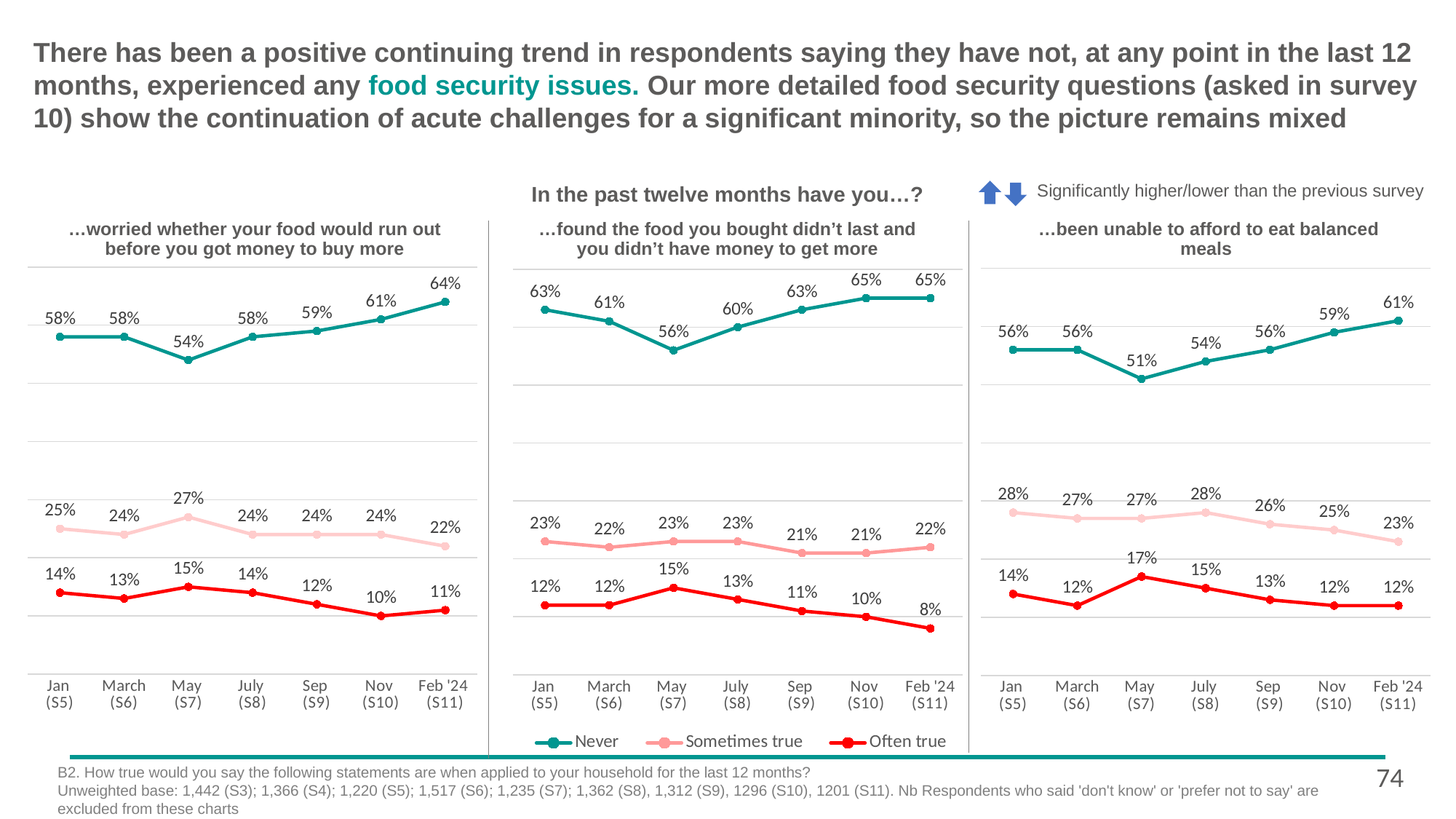
In the '…worried whether your food would run out before you got money to buy more' chart, at which survey is the 'Often true' value highest? May (S7) What kind of chart is used on this slide? Line chart In the '…been unable to afford to eat balanced meals' chart, which is larger: the 'Often true' value for May (S7) or for Feb '24 (S11)? May (S7) In the '…found the food you bought didn't last and you didn't have money to get more' chart, what is the 'Often true' value for Feb '24 (S11)? 8% In the '…worried whether your food would run out before you got money to buy more' chart, does the 'Never' series rise or fall from May (S7) to Feb '24 (S11)? Rise In the '…worried whether your food would run out before you got money to buy more' chart, what is the 'Never' value for Feb '24 (S11)? 64% In the '…found the food you bought didn't last and you didn't have money to get more' chart, what is the difference between the 'Never' values for May (S7) and Feb '24 (S11)? 9 percentage points In the '…been unable to afford to eat balanced meals' chart, at which survey is the 'Never' value lowest? May (S7) Which series is shown in the darkest red line in the legend? Often true How many survey points are plotted along the x axis of each chart? 7 How many series does the legend list? 3 In the '…been unable to afford to eat balanced meals' chart, what is the 'Sometimes true' value for Jan (S5)? 28%